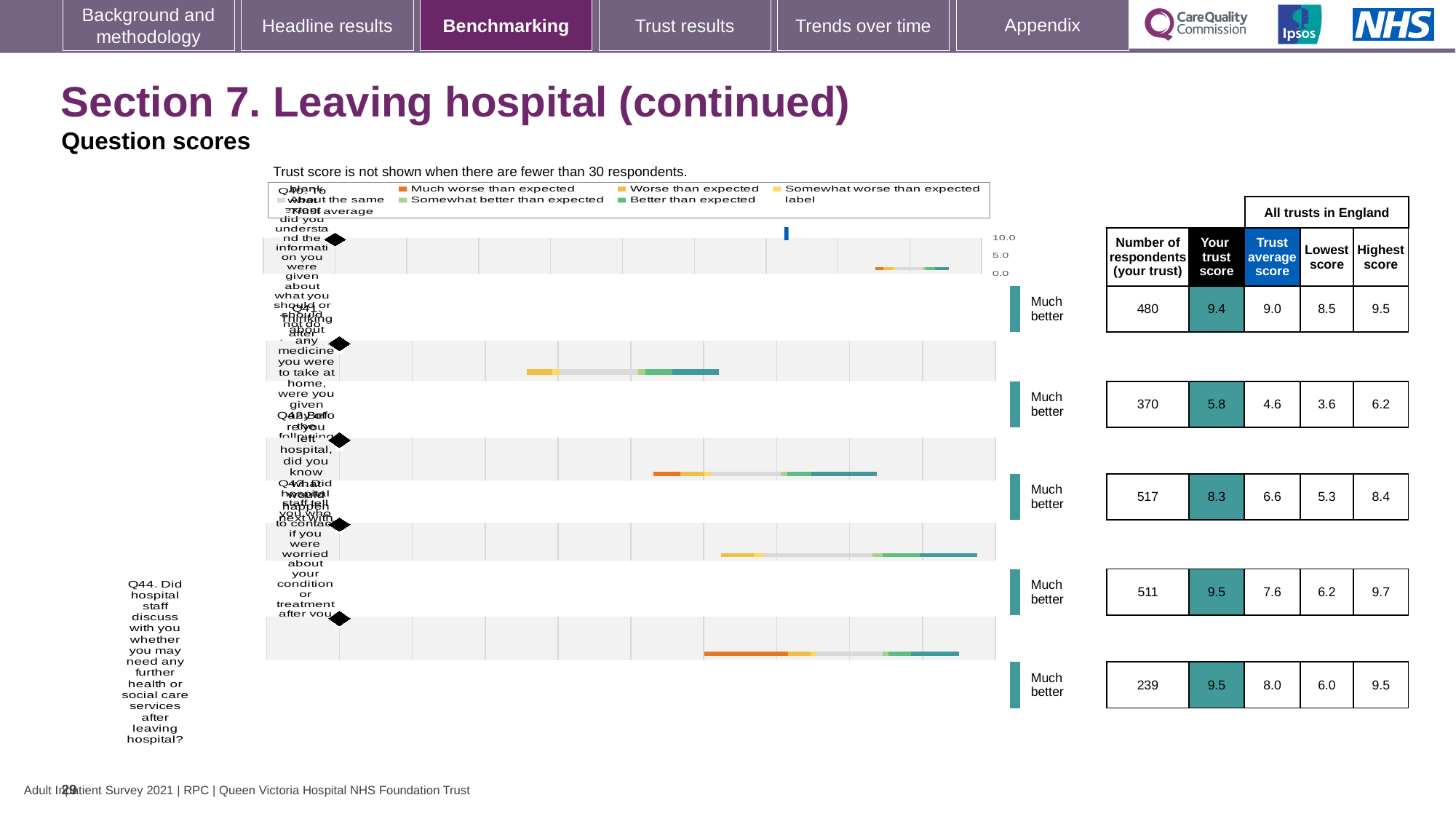
How many respondents (your trust) are shown for Q44? 239 What is the 'Trust average score' for Q44? 8.0 What rating label appears beside each question row in the chart? Much better For the row with 480 respondents, which is larger: the 'Your trust score' or the 'Trust average score'? Your trust score What is the highest 'Number of respondents (your trust)' shown in the table? 517 What kind of chart is used to show the question scores on this slide? Bar chart What is the 'Lowest score' across all trusts in England for Q44? 6.0 What is the 'Your trust score' for Q44 (Did hospital staff discuss with you whether you may need any further health or social care services after leaving hospital?)? 9.5 What is the difference between the 'Your trust score' and the 'Trust average score' for Q44? 1.5 For the row with 370 respondents, what is the 'Highest score' across all trusts in England? 6.2 How many question rows are shown in the benchmarking chart? 5 What is the lowest 'Your trust score' shown in the table on this slide? 5.8